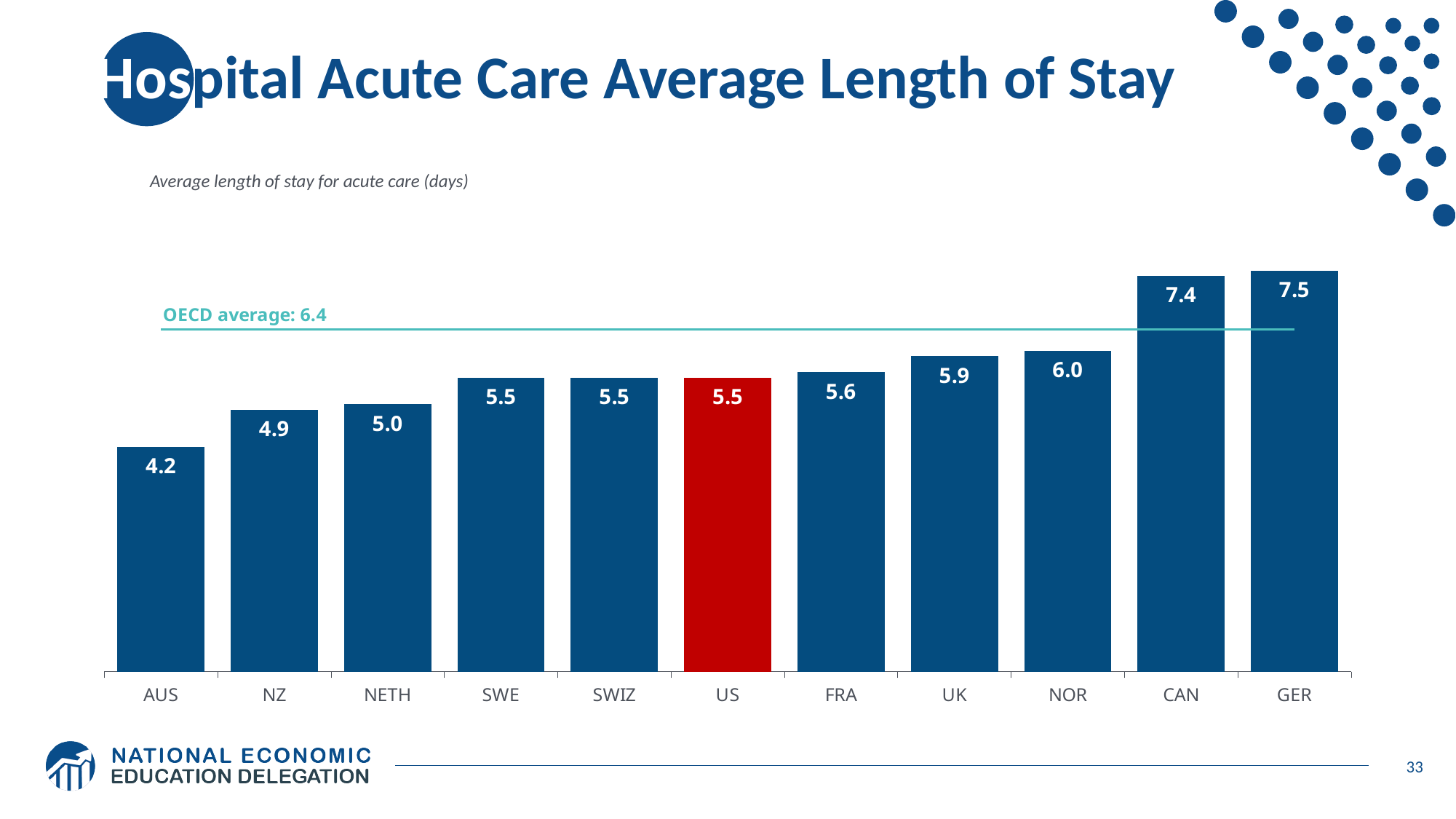
Which country has the highest average length of stay for acute care? GER Do the values generally rise or fall from left to right across the countries? Rise Which country has the lowest average length of stay for acute care? AUS What is the OECD average shown by the horizontal line on the chart? 6.4 What is the average length of stay for acute care in Australia (AUS)? 4.2 What is the difference in average length of stay between NOR and NZ? 1.1 What kind of chart is shown on the slide? Bar chart What is the average length of stay for acute care in Canada (CAN)? 7.4 How many countries are shown in the chart? 11 Which has a longer average length of stay, UK or NETH? UK What is the average length of stay for acute care in the US? 5.5 What is the difference in average length of stay between GER and AUS? 3.3